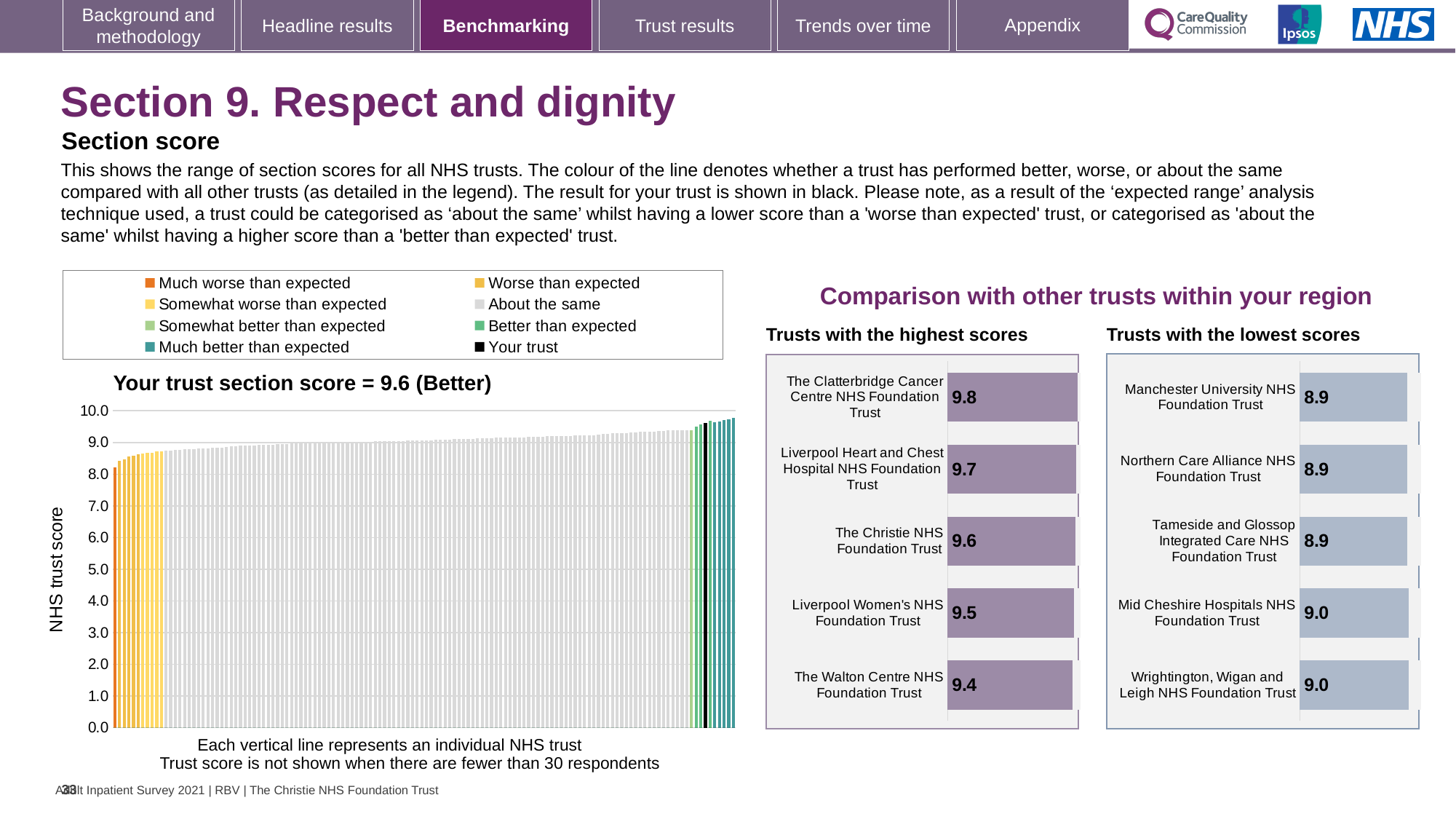
In the 'Trusts with the highest scores' chart, what is the score for The Clatterbridge Cancer Centre NHS Foundation Trust? 9.8 In the 'Your trust section score' chart, is the value of the leftmost (lowest) bar greater or less than 8.0? greater In the 'Your trust section score' chart, do the bars rise or fall from left to right? rise In the 'Trusts with the highest scores' chart, what is the difference between the scores of The Clatterbridge Cancer Centre NHS Foundation Trust and The Walton Centre NHS Foundation Trust? 0.4 In the 'Your trust section score' chart, what is the label on the y axis? NHS trust score In the 'Trusts with the lowest scores' chart, what is the score for Mid Cheshire Hospitals NHS Foundation Trust? 9.0 In the 'Trusts with the highest scores' chart, which trust has the lowest score? The Walton Centre NHS Foundation Trust In the 'Your trust section score' chart, what is the section score for your trust? 9.6 Which is larger: the score for The Clatterbridge Cancer Centre NHS Foundation Trust in the 'Trusts with the highest scores' chart or the score for Manchester University NHS Foundation Trust in the 'Trusts with the lowest scores' chart? The Clatterbridge Cancer Centre NHS Foundation Trust In the 'Trusts with the highest scores' chart, how many trusts are shown? 5 In the 'Your trust section score' chart, how many entries does the legend list? 8 In the 'Your trust section score' chart, what kind of chart is shown? bar chart